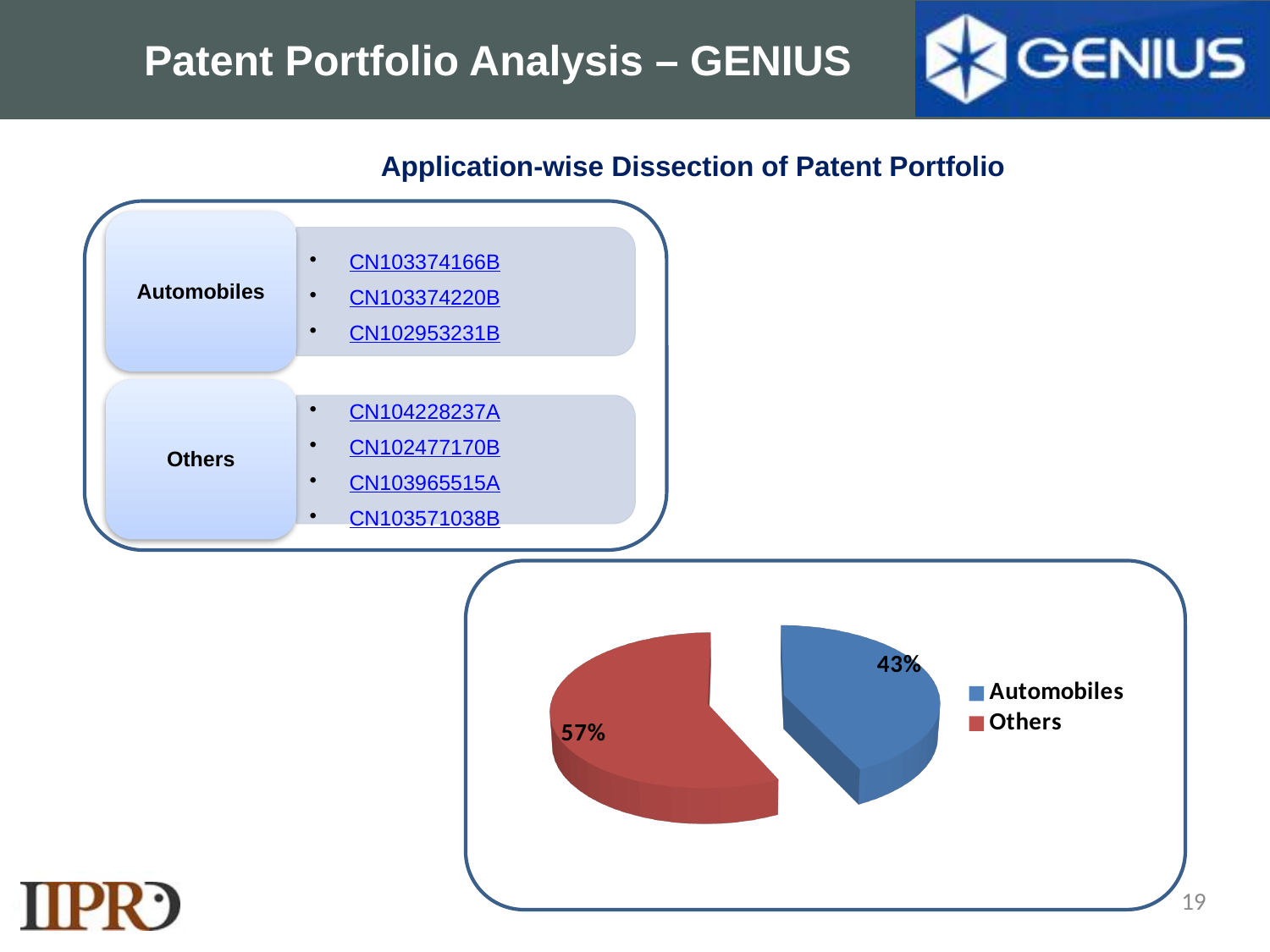
Is the share for Automobiles greater or less than 50%? less What is the difference in percentage points between the Others slice and the Automobiles slice? 14 Which is larger, the Automobiles slice or the Others slice? Others What kind of chart is shown on the slide? pie chart How many entries does the legend list? 2 What colour is the Others slice in the pie chart? red How many slices does the pie chart have? 2 What colour is the Automobiles slice in the pie chart? blue What share of the pie does Others represent? 57% Which slice of the pie is the smallest? Automobiles Which slice of the pie is the largest? Others What share of the pie does Automobiles represent? 43%